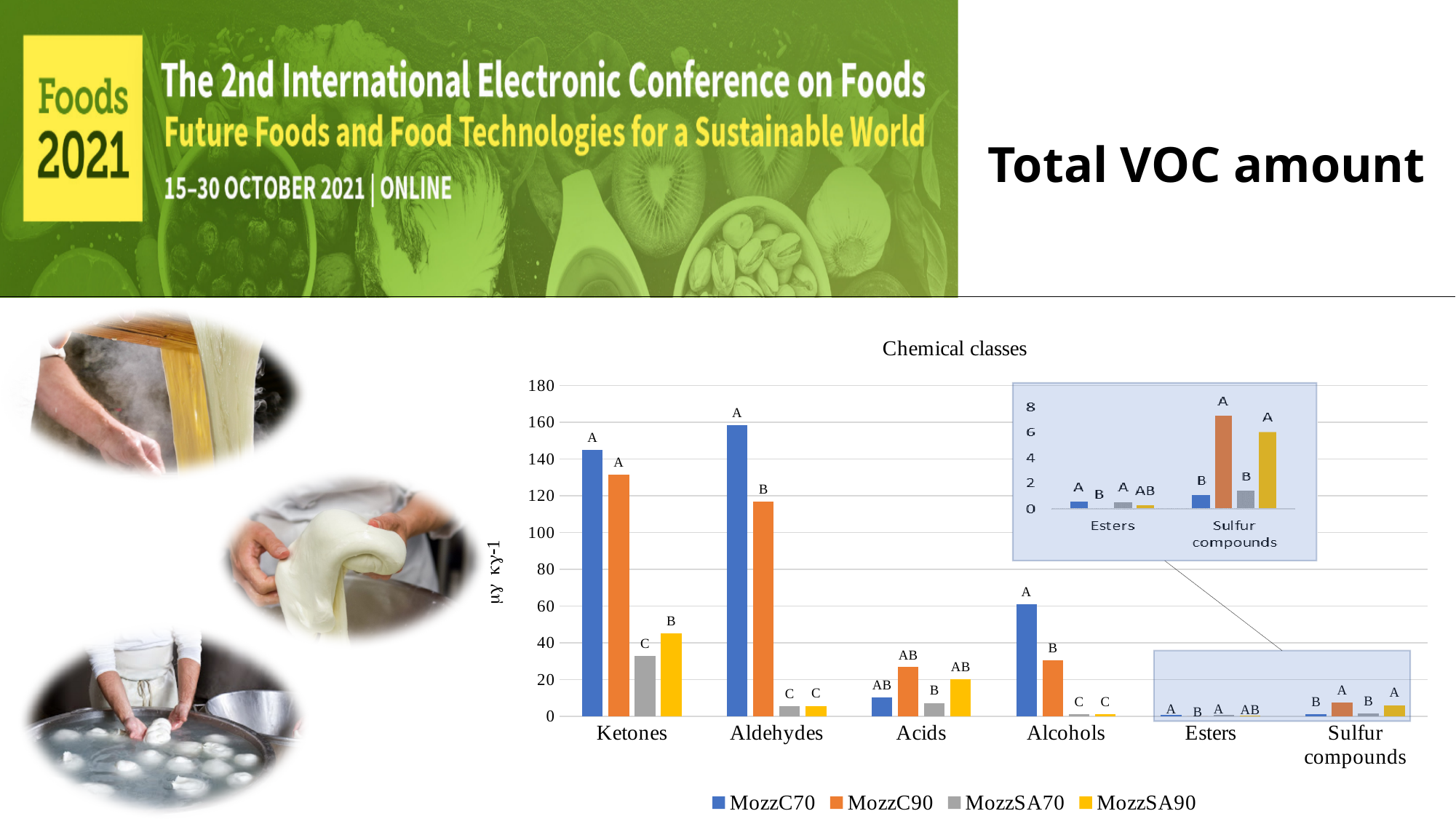
For Alcohols, which is larger: the MozzC70 bar or the MozzC90 bar? MozzC70 Is the MozzC70 value for Aldehydes greater or less than 140? greater Which series has the highest bar for Ketones? MozzC70 For which chemical class is the MozzC70 bar the highest? Aldehydes For Ketones, which is larger: the MozzSA70 bar or the MozzSA90 bar? MozzSA90 How many series does the legend of the chart list? 4 Which series has the highest bar for Sulfur compounds in the inset chart? MozzC90 What kind of chart is shown on the slide? bar chart How many chemical class categories are shown on the x axis of the main chart? 6 Is the MozzC90 value for Alcohols greater or less than 40? less Is the MozzC90 value for Ketones greater or less than 120? greater What is the title of the chart? Chemical classes